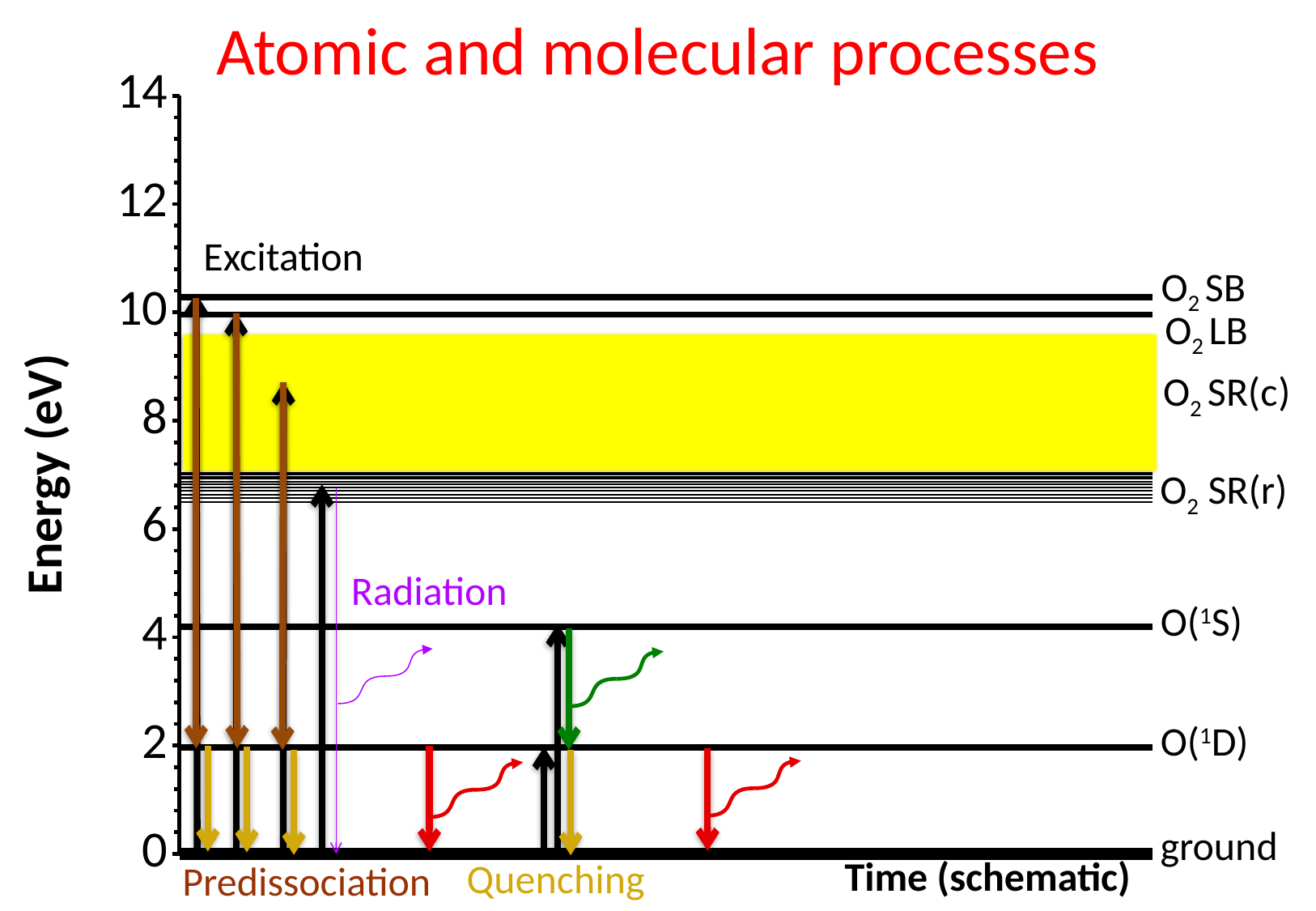
What is the title of the diagram? Atomic and molecular processes Is the energy of the O(1S) level greater or less than 6 eV? less Which level has the higher energy, O(1S) or O(1D)? O(1S) Is the energy of the O2 SR(r) levels greater or less than 8 eV? less Is the energy of the O(1D) level greater or less than 4 eV? less What is the label of the vertical axis? Energy (eV) What is the energy of the ground level in eV? 0 How many labeled energy levels are shown on the right side of the diagram? 7 Which labeled energy level lies highest on the diagram? O2 SB What is the energy of the O(1D) level in eV? 2 Which labeled energy level lies lowest on the diagram? ground